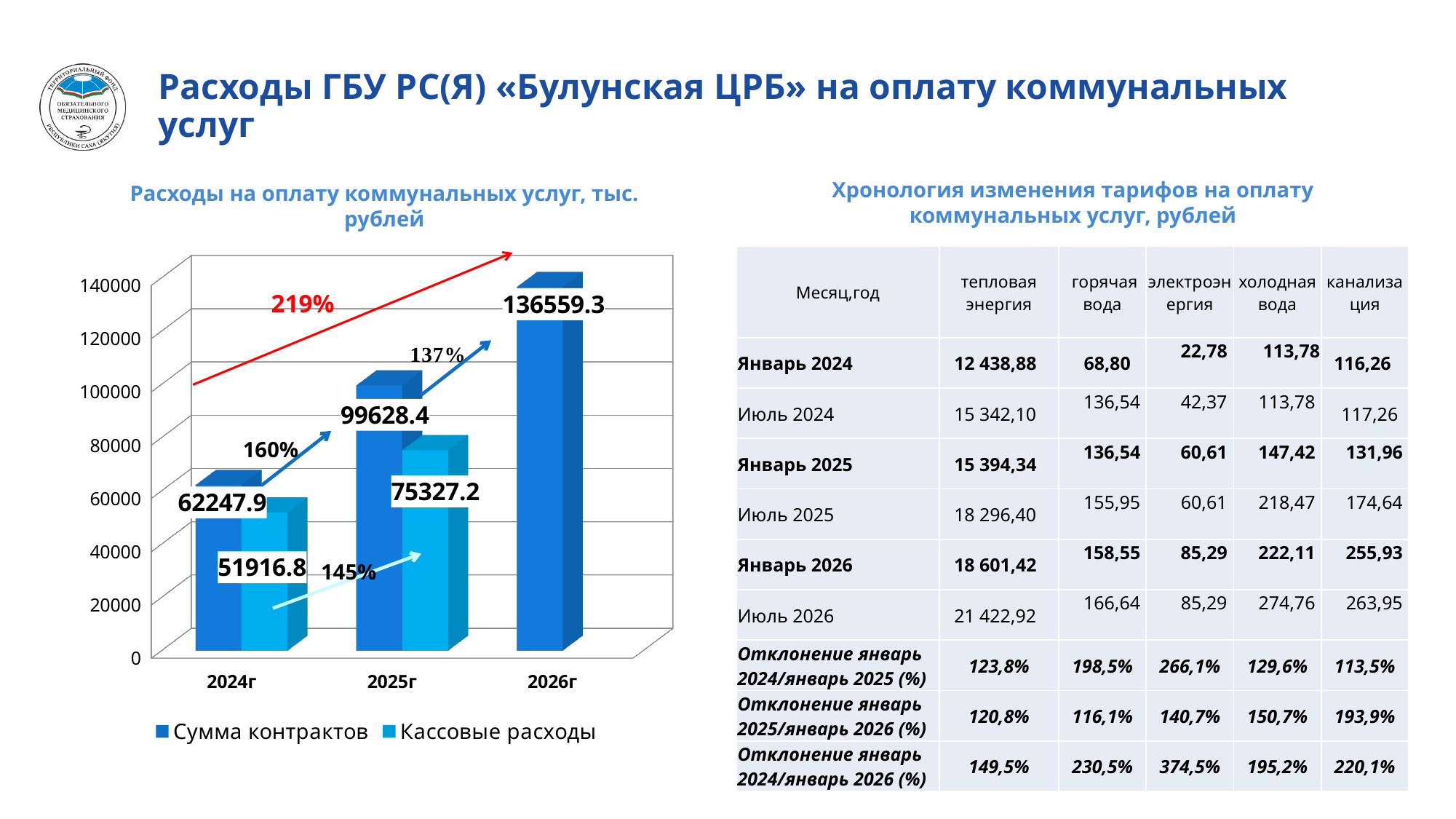
How many series does the chart legend list? 2 What percentage label is shown in red above the chart? 219% Is the value of Сумма контрактов for 2026г greater or less than 120000? greater What is the value of Кассовые расходы for 2025г? 75327.2 What is the value of Сумма контрактов for 2024г? 62247.9 Which year has the lowest value of Кассовые расходы? 2024г What is the difference between Сумма контрактов and Кассовые расходы for 2025г? 24301.2 What kind of chart is shown on the slide? bar chart Which year has the highest value of Сумма контрактов? 2026г What is the difference between Сумма контрактов for 2025г and 2024г? 37380.5 Which is larger for 2024г: Сумма контрактов or Кассовые расходы? Сумма контрактов What is the value of Сумма контрактов for 2026г? 136559.3